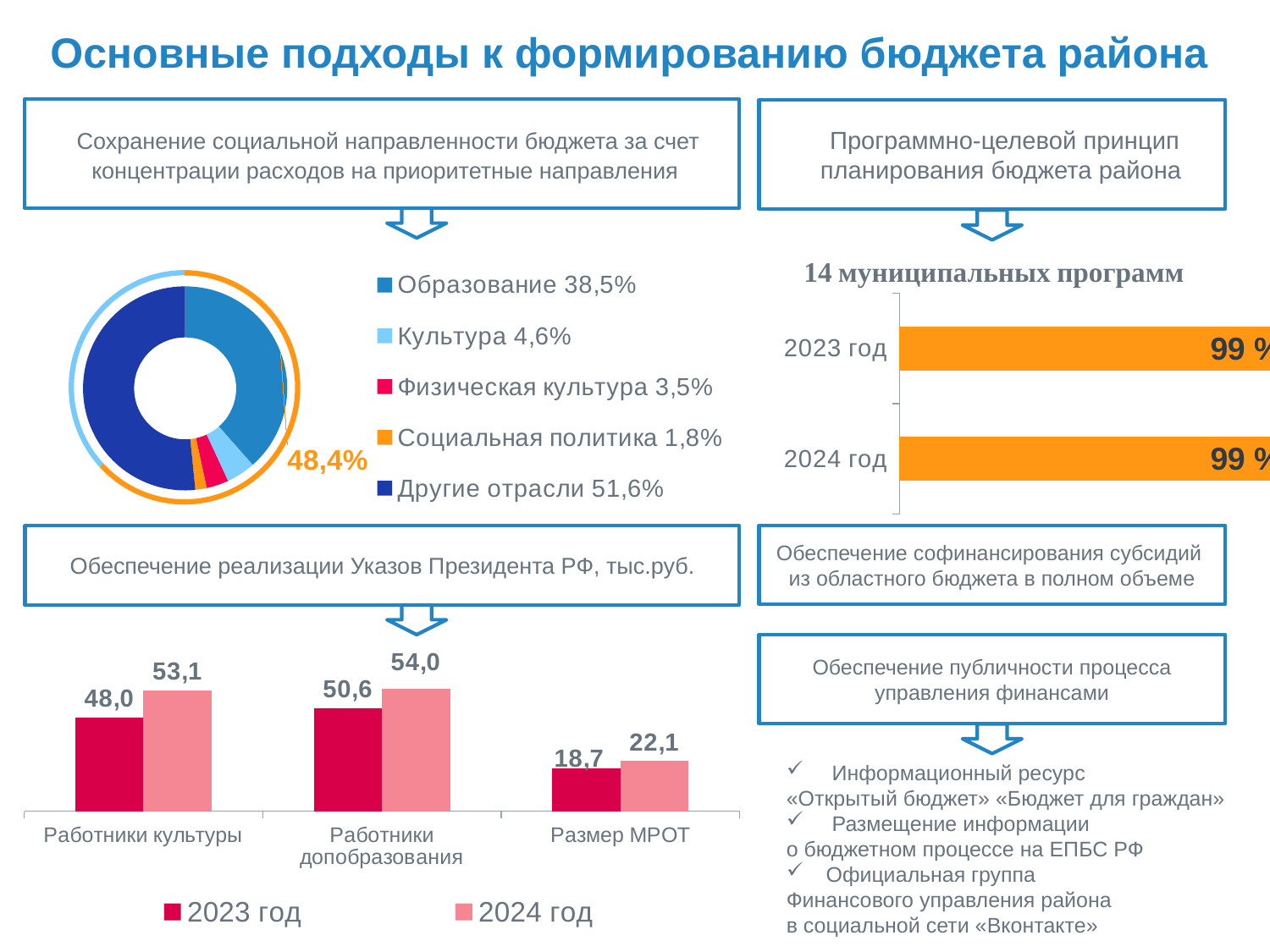
In the bottom-left bar chart, which is larger for 2023 год: Работники культуры or Работники допобразования? Работники допобразования In the bottom-left bar chart, which category has the highest value for 2024 год? Работники допобразования In the doughnut chart on the left, which category has the largest share? Другие отрасли In the bottom-left bar chart, which category has the lowest value for 2023 год? Размер МРОТ How many categories are shown in the bar chart titled 14 муниципальных программ? 2 In the bottom-left bar chart, what is the value for Размер МРОТ in 2023 год? 18,7 How many categories are shown in the bottom-left bar chart? 3 What kind of chart is the bottom-left chart showing Работники культуры, Работники допобразования and Размер МРОТ? bar chart In the doughnut chart on the left, what share does Образование have? 38,5% In the bottom-left bar chart (Обеспечение реализации Указов Президента РФ, тыс.руб.), what is the value for Работники культуры in 2024 год? 53,1 How many series does the legend of the bottom-left bar chart list? 2 In the bottom-left bar chart, what is the difference between the 2024 год and 2023 год values for Работники допобразования? 3,4